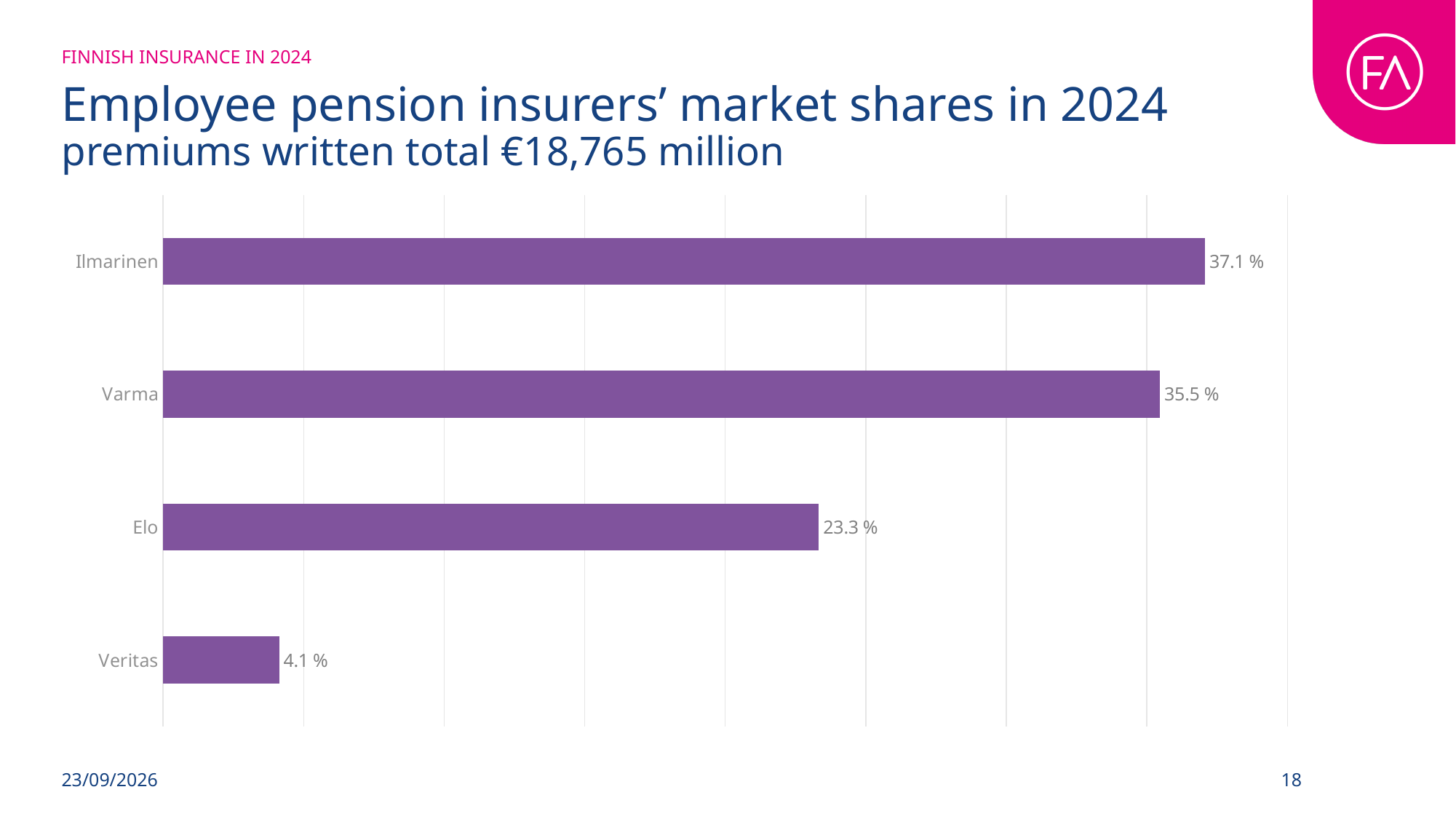
How many insurers are shown in the chart? 4 What is the total of premiums written stated in the slide subtitle? €18,765 million What is the market share of Elo? 23.3 % Which insurer has the lowest market share? Veritas What is the difference in market share between Elo and Veritas? 19.2 % What is the market share of Varma? 35.5 % Which insurer has the highest market share? Ilmarinen What is the difference in market share between Ilmarinen and Varma? 1.6 % What is the market share of Veritas? 4.1 % Which has a larger market share, Elo or Veritas? Elo What kind of chart is shown on the slide? Bar chart What is the market share of Ilmarinen? 37.1 %